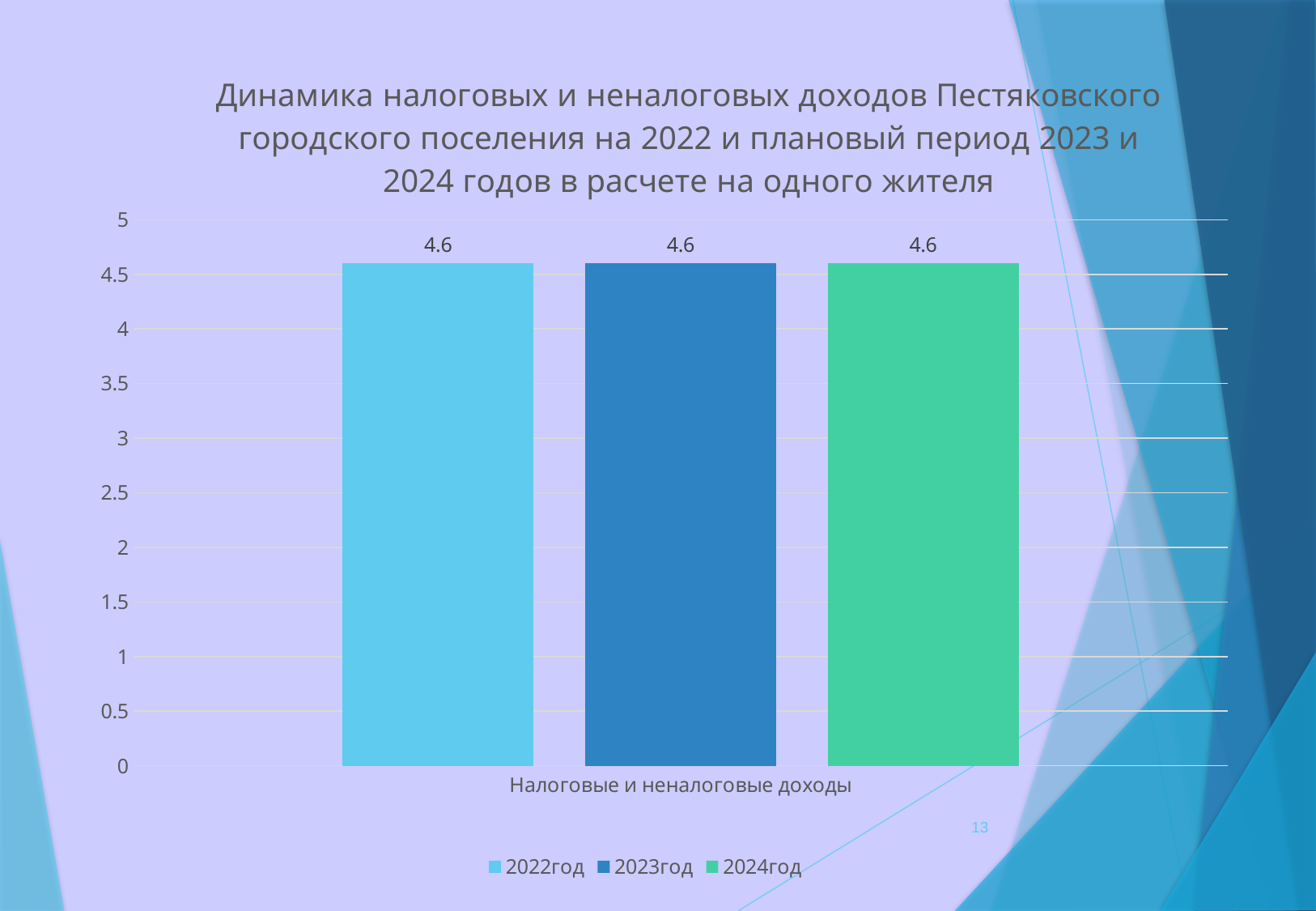
How many series does the legend list? 3 Is the value for 2024год greater or less than 5? less What kind of chart is shown on the slide? bar chart Which series is shown in green? 2024год What is the value for 2022год for Налоговые и неналоговые доходы? 4.6 What is the label of the category on the x axis? Налоговые и неналоговые доходы What is the value for 2024год for Налоговые и неналоговые доходы? 4.6 Is the value for 2023год greater or less than 4? greater What is the value for 2023год for Налоговые и неналоговые доходы? 4.6 What is the difference between the values for 2024год and 2022год? 0 Do the values rise, fall or stay the same from 2022год to 2024год? stay the same How many categories are shown on the x axis? 1